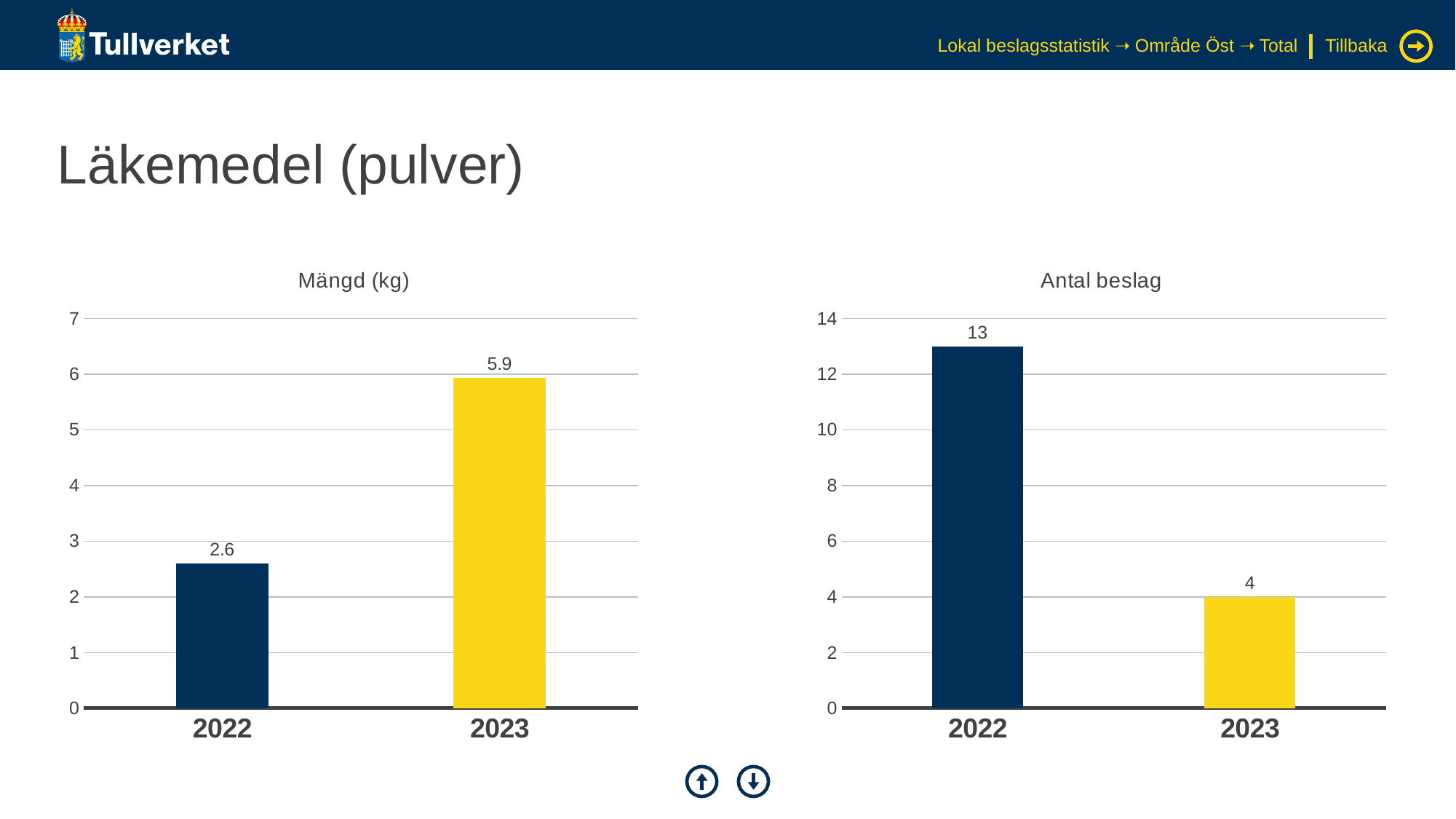
In the 'Antal beslag' chart, which is larger, the value for 2022 or 2023? 2022 In the 'Mängd (kg)' chart, which year has the highest value? 2023 In the 'Antal beslag' chart, what is the difference between the 2022 and 2023 values? 9 In the 'Mängd (kg)' chart, what is the value for 2022? 2.6 In the 'Mängd (kg)' chart, what is the difference between the 2023 and 2022 values? 3.3 In the 'Antal beslag' chart, which year has the lowest value? 2023 In the 'Mängd (kg)' chart, do the values rise or fall from 2022 to 2023? rise In the 'Antal beslag' chart, what is the value for 2023? 4 In the 'Antal beslag' chart, what is the value for 2022? 13 In the 'Mängd (kg)' chart, what is the value for 2023? 5.9 How many categories are shown on the x axis of the 'Mängd (kg)' chart? 2 What kind of chart is the 'Antal beslag' chart? bar chart